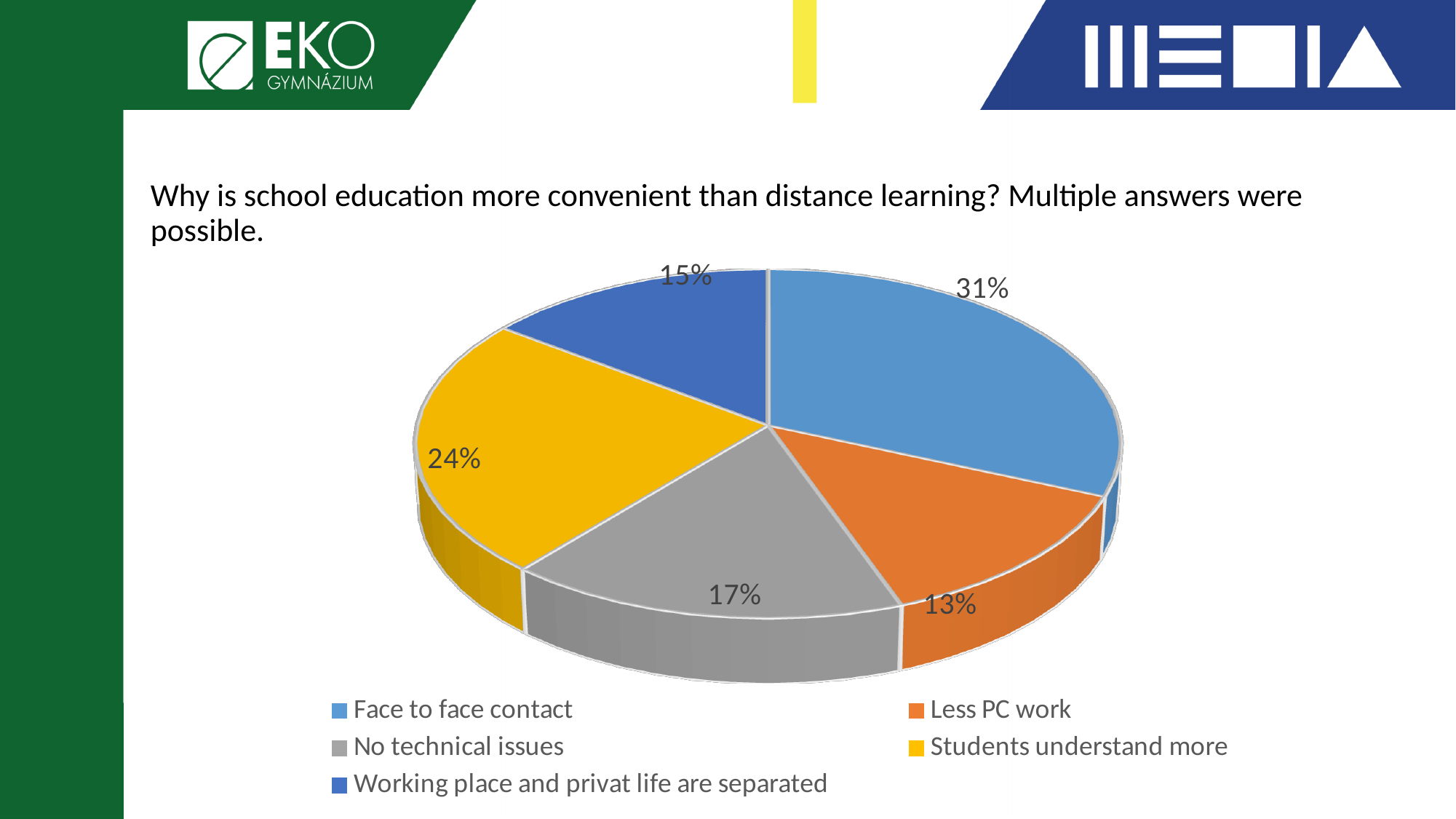
What colour is the slice for "Students understand more"? yellow What share of the pie does "No technical issues" have? 17% What kind of chart is shown on the slide? pie chart What share of the pie does "Face to face contact" have? 31% What is the difference in percentage points between "Face to face contact" and "Students understand more"? 7 Which category has the largest slice of the pie? Face to face contact How many categories does the pie chart show? 5 What share of the pie does "Working place and privat life are separated" have? 15% Which is larger, the share for "No technical issues" or the share for "Working place and privat life are separated"? No technical issues What share of the pie does "Students understand more" have? 24% Which category has the smallest slice of the pie? Less PC work What share of the pie does "Less PC work" have? 13%